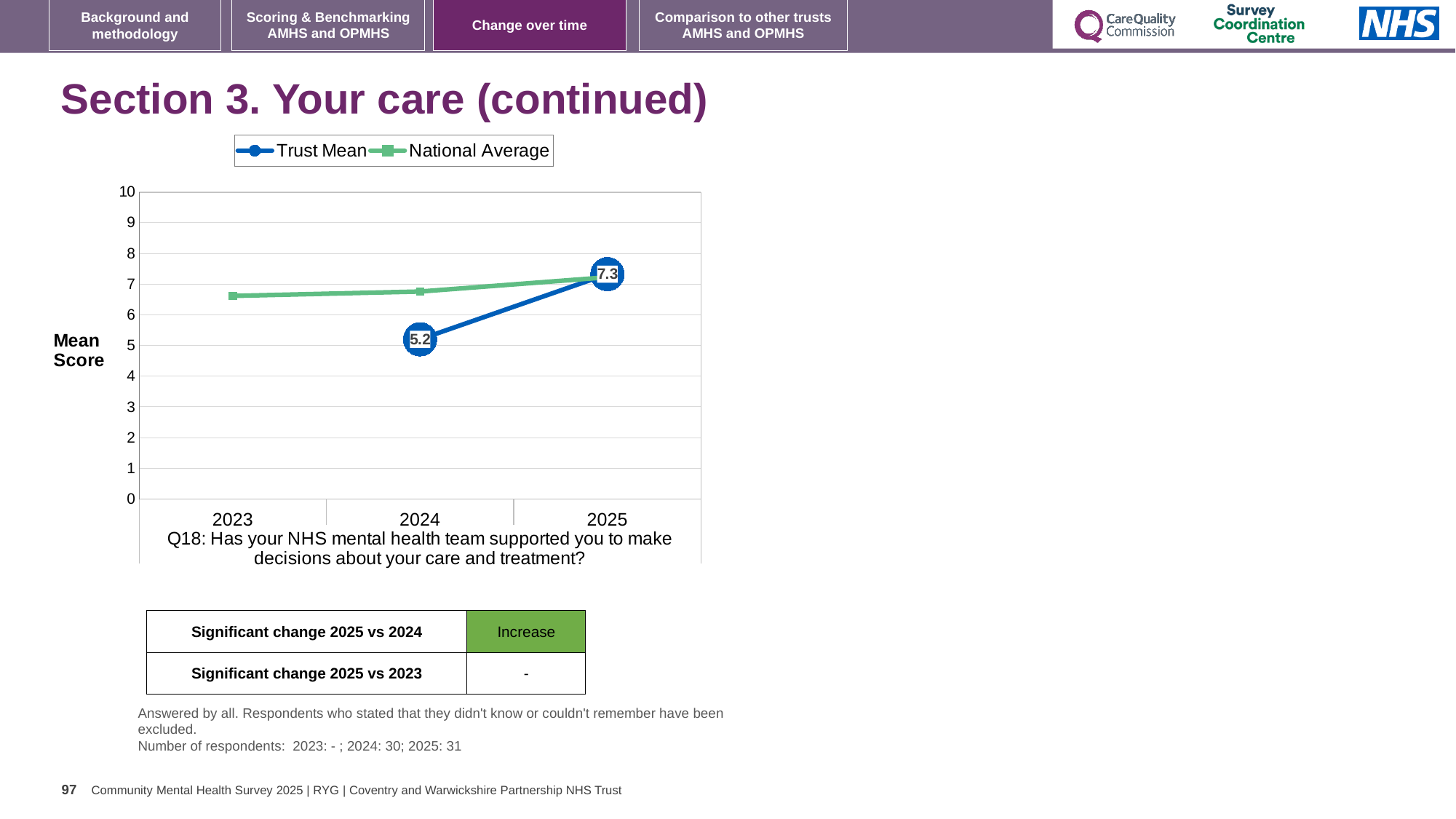
What is the Trust Mean score for 2024? 5.2 In 2024, which series has the higher value, Trust Mean or National Average? National Average Which year has the higher Trust Mean score, 2024 or 2025? 2025 Is the National Average value for 2023 greater or less than 7? less Is the Trust Mean value for 2024 greater or less than 6? less By how much did the Trust Mean score increase from 2024 to 2025? 2.1 How many years are shown on the x axis? 3 What is the Trust Mean score for 2025? 7.3 Does the Trust Mean rise or fall from 2024 to 2025? rise Is the National Average value for 2024 greater or less than 6? greater How many series does the legend list? 2 What kind of chart is shown on the slide? line chart